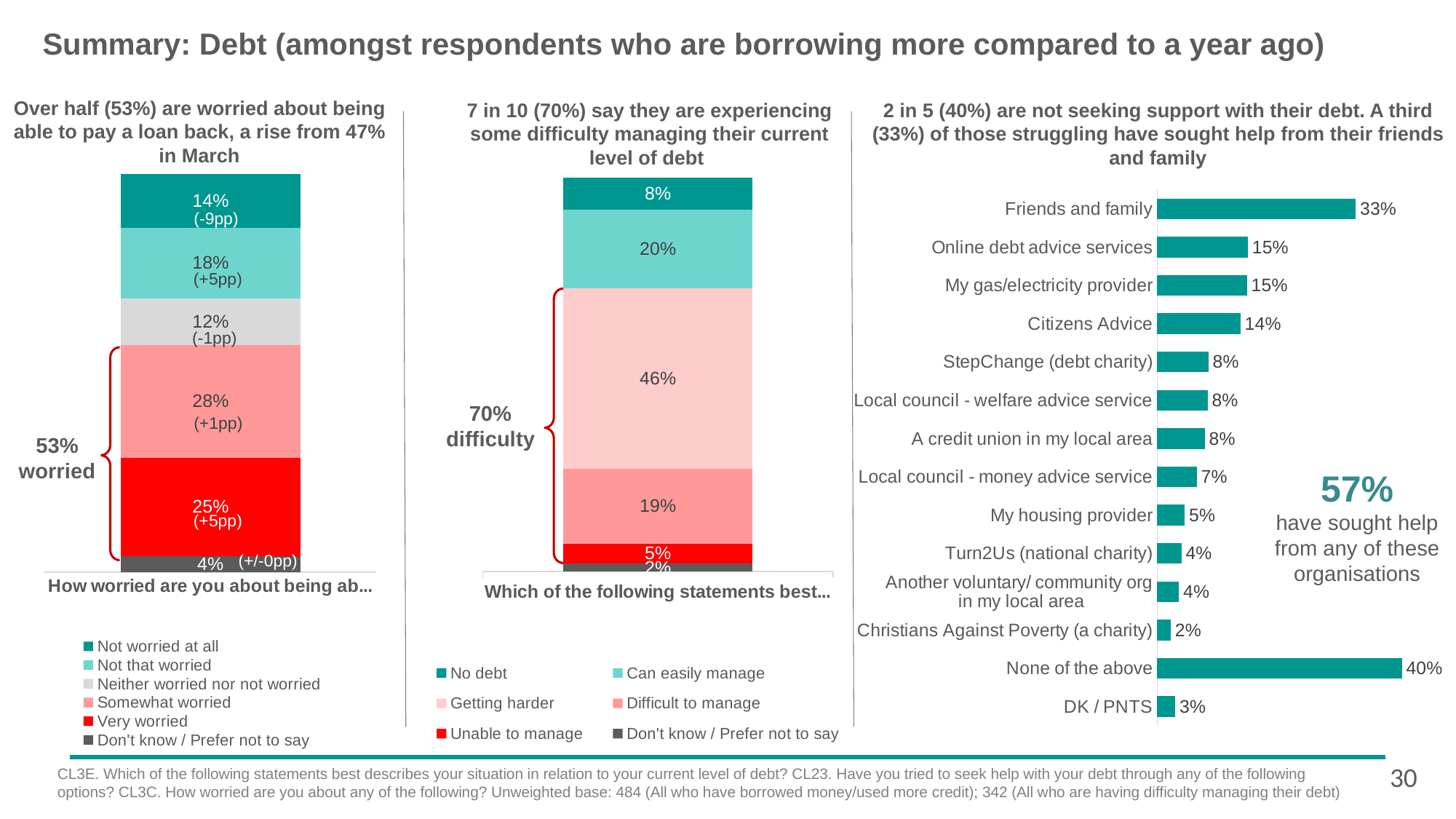
In the middle chart on managing current debt, what percentage say it is 'Getting harder'? 46% In the left chart on how worried respondents are, what is the difference between the 'Not that worried' and 'Neither worried nor not worried' segments? 6% In the left chart on how worried respondents are, how many entries does the legend list? 6 In the right chart on sources of help with debt, what percentage sought help from Citizens Advice? 14% In the middle chart on managing current debt, which segment is the largest? Getting harder In the right chart on sources of help with debt, which category has the lowest value? Christians Against Poverty (a charity) What type of chart is the right chart on sources of help with debt? Bar chart In the right chart on sources of help with debt, what is the difference between 'Friends and family' and 'Online debt advice services'? 18% In the left chart on how worried respondents are, what percentage are 'Somewhat worried'? 28% In the right chart on sources of help with debt, which category has the highest value? None of the above In the middle chart on managing current debt, what is the combined total of 'Getting harder', 'Difficult to manage' and 'Unable to manage'? 70% In the left chart on how worried respondents are about paying a loan back, what percentage are 'Very worried'? 25%